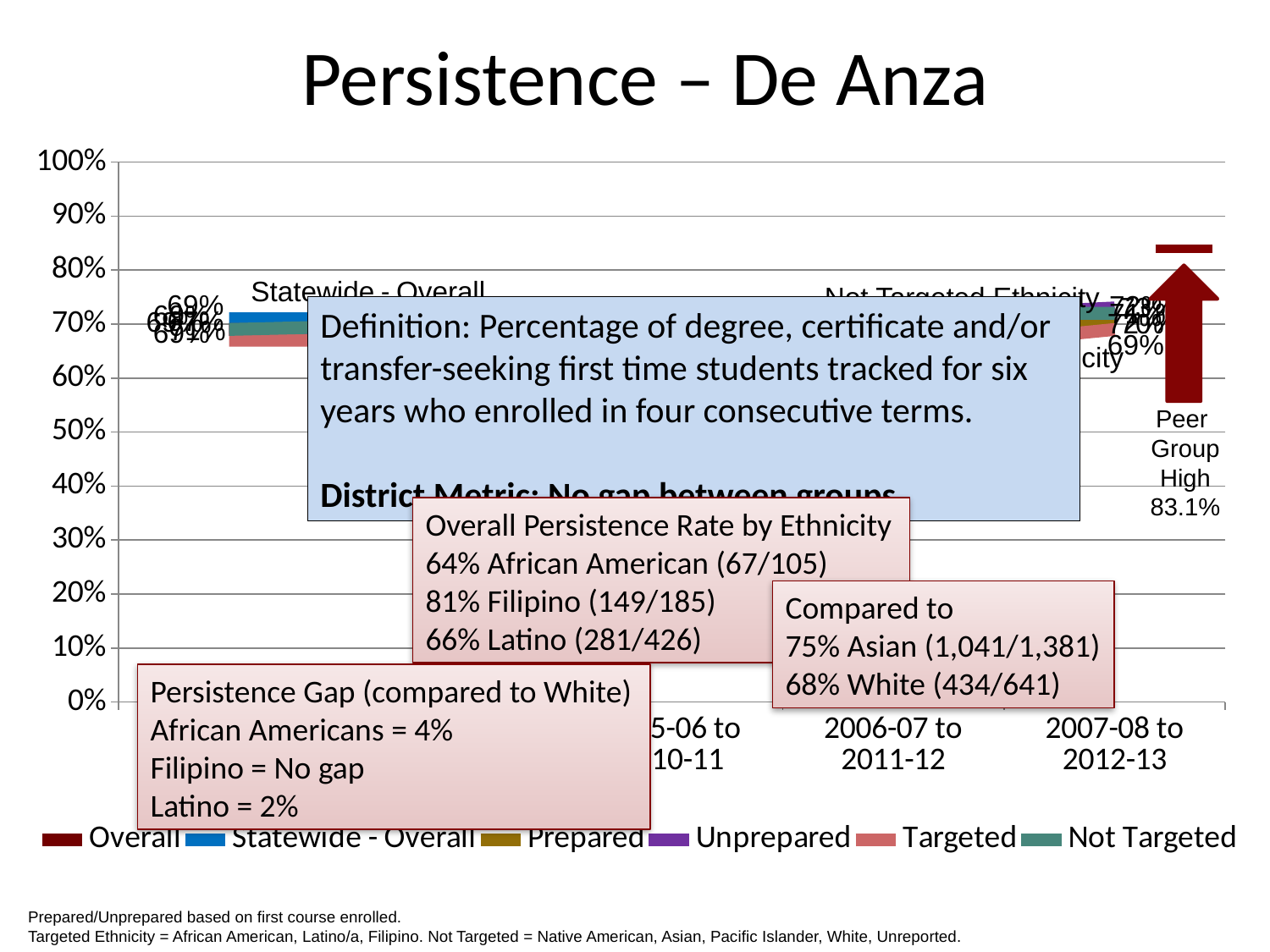
Which series is listed first in the chart legend? Overall Is the value for Not Targeted in the 2006-07 to 2011-12 period greater or less than 40%? greater What is the title of the slide's chart? Persistence – De Anza Is the value for Targeted in the 2007-08 to 2012-13 period greater or less than 90%? less Is the value for Statewide - Overall in the 2007-08 to 2012-13 period greater or less than 50%? greater What kind of chart is shown on the slide? line chart How many series does the chart legend list? 6